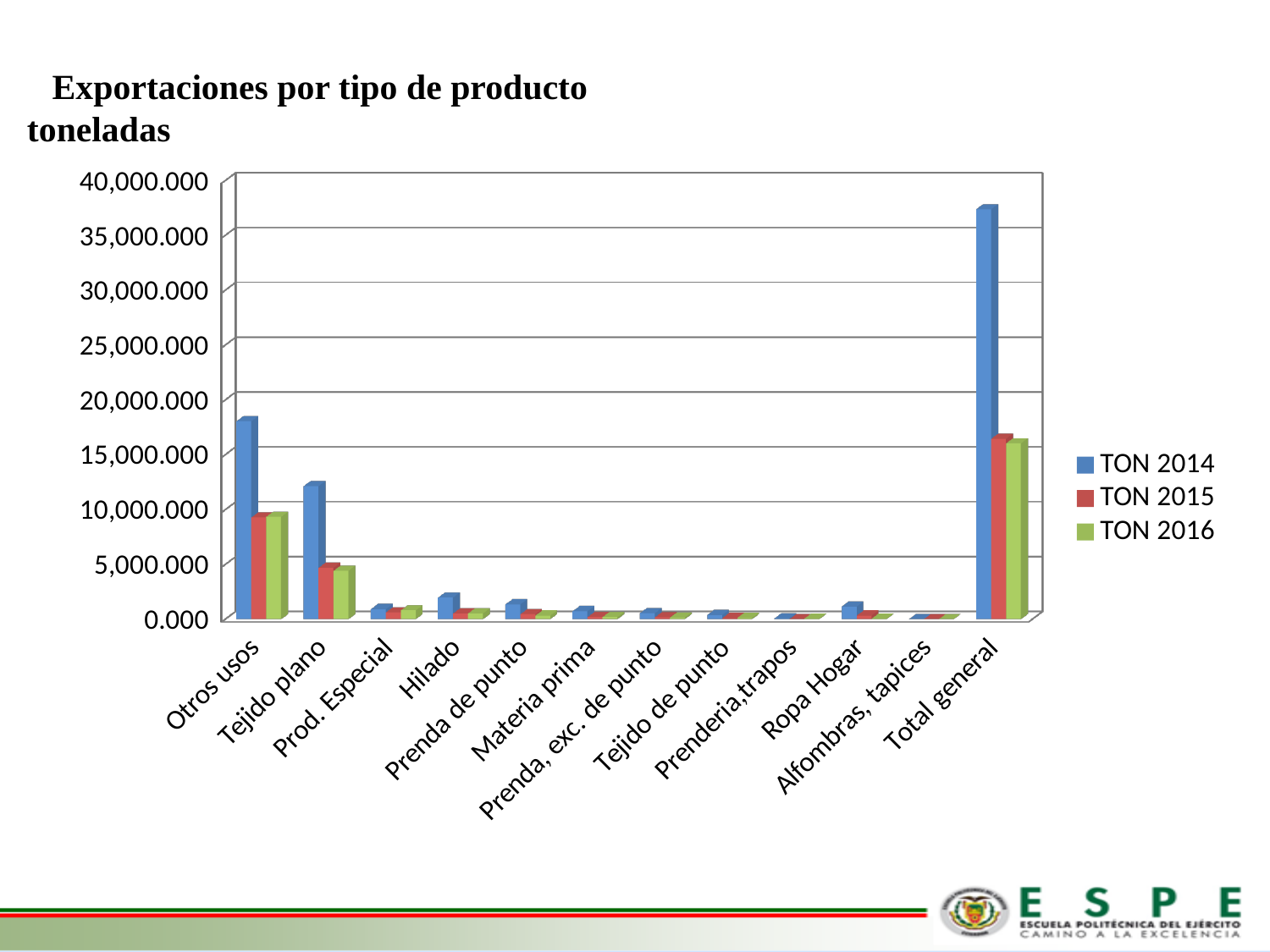
Excluding Total general, which category has the highest TON 2014 value? Otros usos Which category has the highest TON 2014 value? Total general How many categories are shown on the x axis? 12 Is the TON 2015 value for Otros usos greater or less than 10,000.000? less Which series is shown in blue in the legend? TON 2014 Is the TON 2014 value for Total general greater or less than 35,000.000? greater What kind of chart is shown on the slide? bar chart How many series does the legend list? 3 For Total general, which is larger: the TON 2014 value or the TON 2016 value? TON 2014 Is the TON 2014 value for Otros usos greater or less than 15,000.000? greater For Otros usos, which is larger: the TON 2014 value or the TON 2015 value? TON 2014